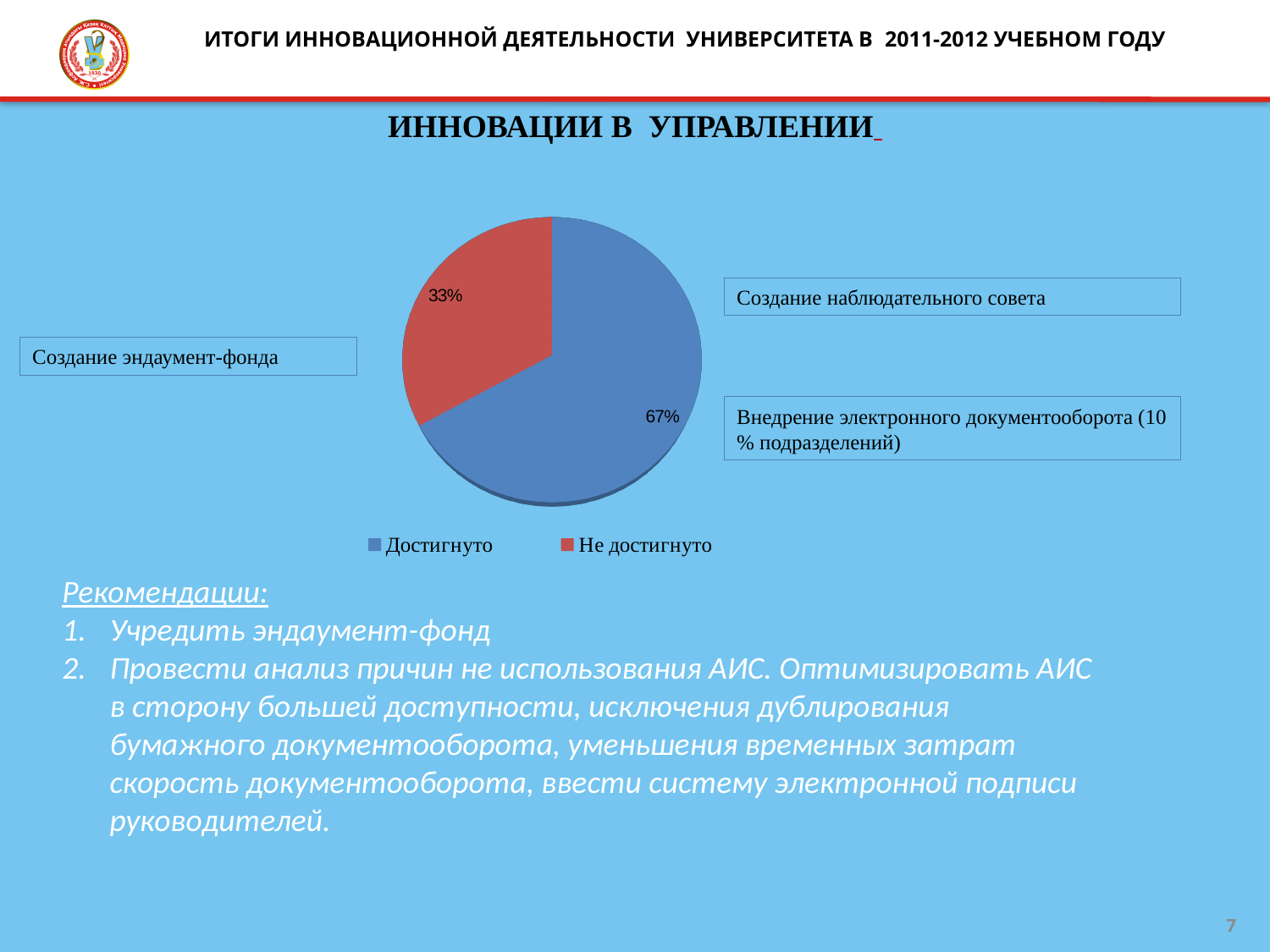
Which is larger, the share for "Достигнуто" or the share for "Не достигнуто"? Достигнуто What colour is the "Достигнуто" slice? blue What kind of chart is shown on the slide? pie chart What colour is the "Не достигнуто" slice? red What share of the pie does "Не достигнуто" represent? 33% How many entries does the legend list? 2 How many slices does the pie chart have? 2 Which slice of the pie is the smallest? Не достигнуто What is the difference in percentage points between the "Достигнуто" and "Не достигнуто" slices? 34 Which slice of the pie is the largest? Достигнуто What share of the pie does "Достигнуто" represent? 67%